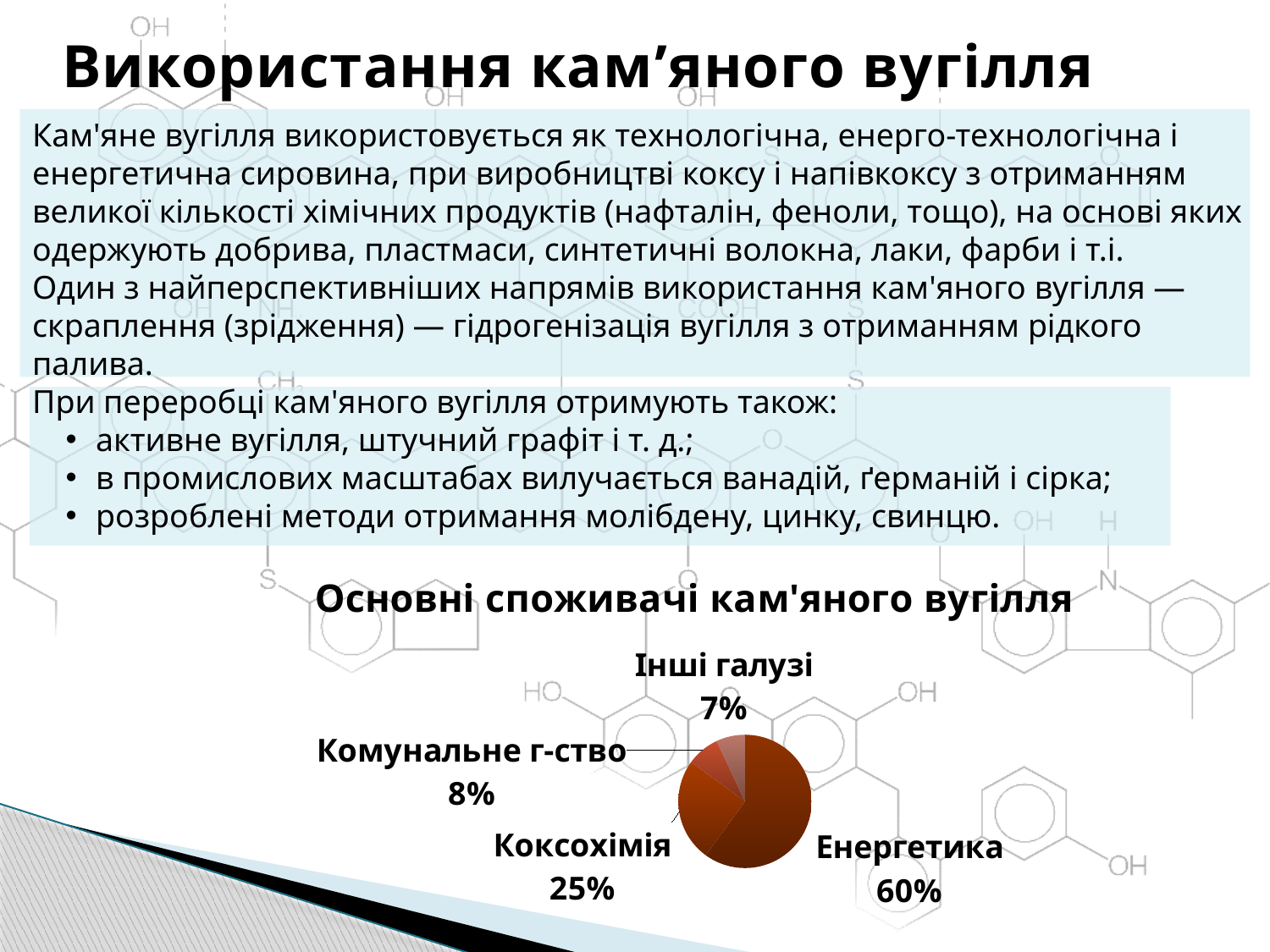
What share of the pie does Коксохімія have? 25% Which category has the largest slice of the pie? Енергетика What is the combined share of Комунальне г-ство and Інші галузі? 15% What is the difference in percentage points between Енергетика and Коксохімія? 35 How many slices does the pie chart have? 4 What share of the pie does Комунальне г-ство have? 8% What is the title of the chart? Основні споживачі кам'яного вугілля Which is larger, the share for Коксохімія or the share for Комунальне г-ство? Коксохімія Which category has the smallest slice of the pie? Інші галузі What type of chart is shown on the slide? pie chart What share of the pie does Інші галузі have? 7% What share of the pie does Енергетика have? 60%